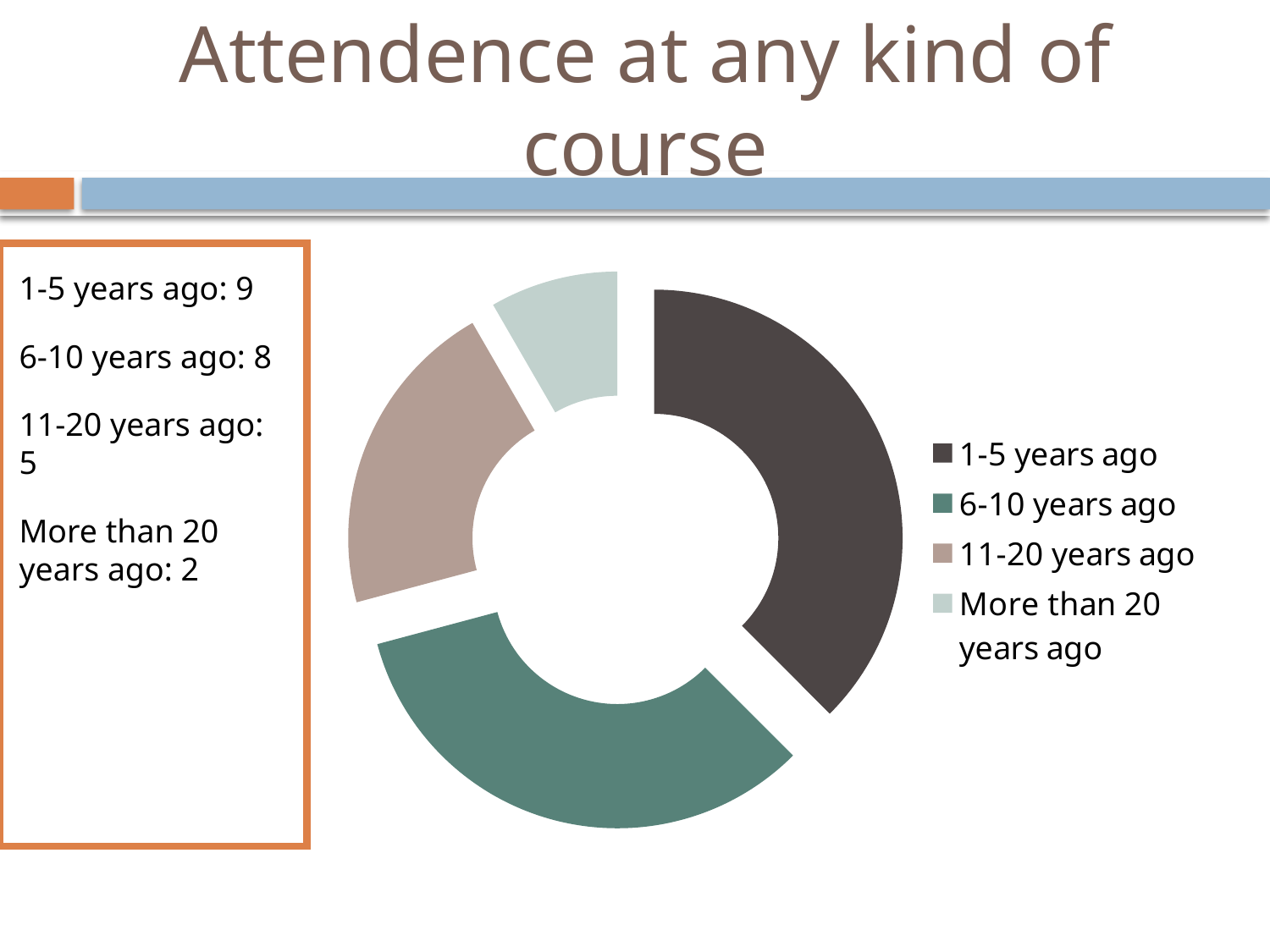
What is the value for 6-10 years ago? 8 Which category has the smallest share of the doughnut chart? More than 20 years ago What is the value for 11-20 years ago? 5 What kind of chart is shown on the slide? Doughnut chart What is the value for 1-5 years ago? 9 What is the title of the slide containing the doughnut chart? Attendence at any kind of course Which category has the largest share of the doughnut chart? 1-5 years ago What is the difference between the values for 1-5 years ago and 11-20 years ago? 4 How many categories does the doughnut chart show? 4 Which is larger, the value for 6-10 years ago or the value for More than 20 years ago? 6-10 years ago What is the total of all four categories in the doughnut chart? 24 What is the value for More than 20 years ago? 2